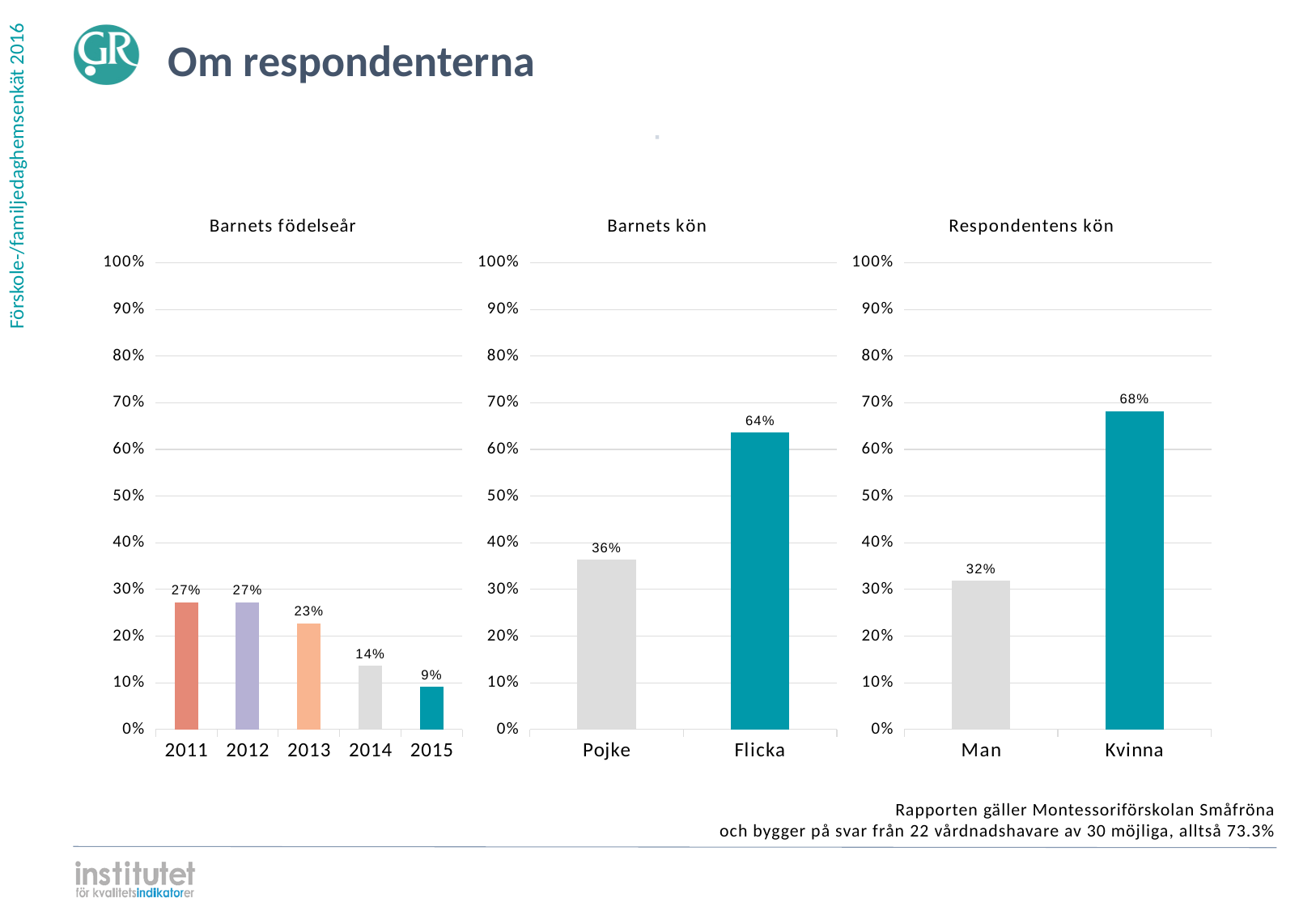
In the 'Barnets födelseår' chart, what is the difference between the values for 2013 and 2014? 9% In the 'Respondentens kön' chart, what is the value for Kvinna? 68% In the 'Respondentens kön' chart, is the value for Man greater or less than 40%? less In the 'Barnets kön' chart, what is the difference between Flicka and Pojke? 28% In the 'Barnets födelseår' chart, how many years are shown on the x axis? 5 In the 'Respondentens kön' chart, which is larger, Man or Kvinna? Kvinna In the 'Barnets födelseår' chart, what is the value for 2013? 23% In the 'Barnets kön' chart, which category is highest? Flicka What kind of chart is the 'Barnets kön' chart? bar chart In the 'Barnets kön' chart, what is the value for Pojke? 36% In the 'Barnets födelseår' chart, which year has the lowest value? 2015 In the 'Barnets födelseår' chart, do the values rise or fall from 2011 to 2015? fall